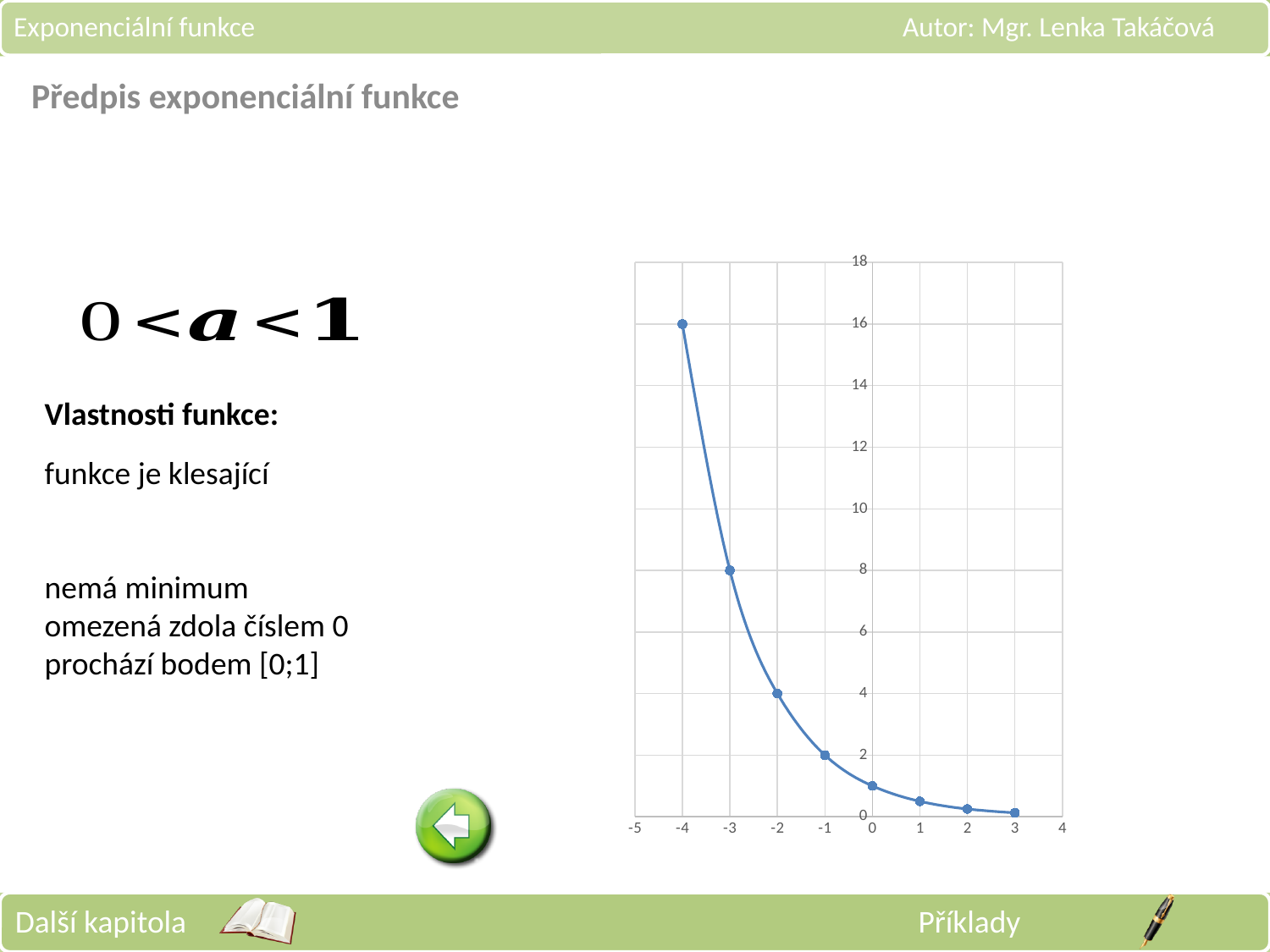
What is the y value of the plotted point at x = -2? 4 What kind of chart is shown on the slide? line chart What is the y value of the plotted point at x = -4? 16 How many data points are plotted on the chart? 8 Do the plotted values rise or fall as x increases? fall What is the y value of the plotted point at x = -3? 8 What is the y value of the plotted point at x = -1? 2 At which x value does the curve reach its highest plotted point? -4 What is the difference between the y values at x = -4 and x = -3? 8 At which x value is the lowest plotted point? 3 Is the y value of the point at x = 0 greater or less than 2? less Which has the larger y value, the point at x = -3 or the point at x = -2? x = -3